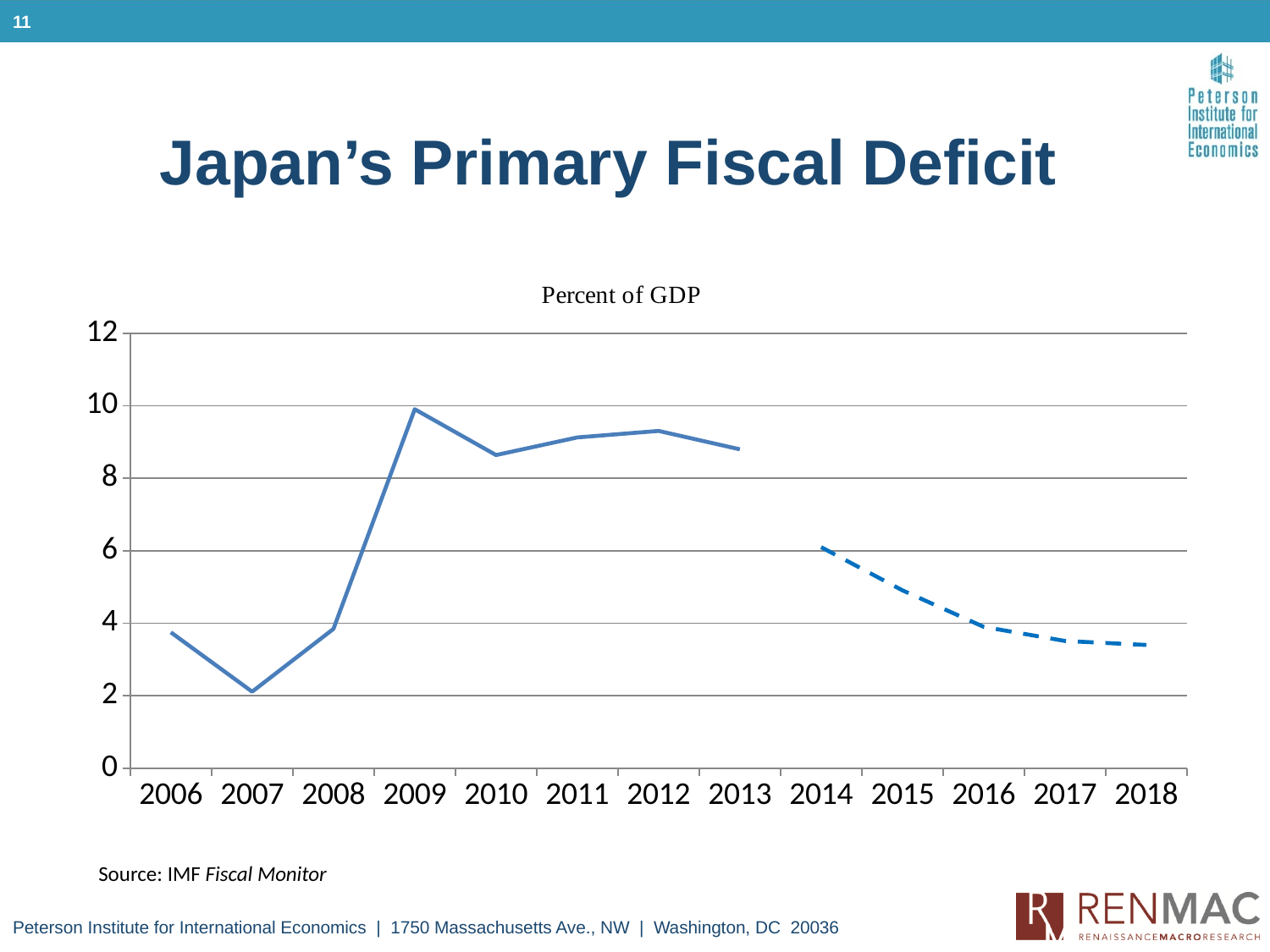
Do the values rise or fall from 2014 to 2018? fall Is the value for 2014 greater or less than 4? greater What kind of chart is shown on the slide? line chart How many years are shown on the x axis of the chart? 13 In which year is Japan's primary fiscal deficit lowest? 2007 Is the value for 2007 greater or less than 4? less In which year is Japan's primary fiscal deficit highest? 2009 Is the value for 2018 greater or less than 6? less Which year has the larger value, 2010 or 2016? 2010 What unit is the chart's vertical axis measured in, according to the label above the chart? Percent of GDP What is the title of the chart on the slide? Japan's Primary Fiscal Deficit